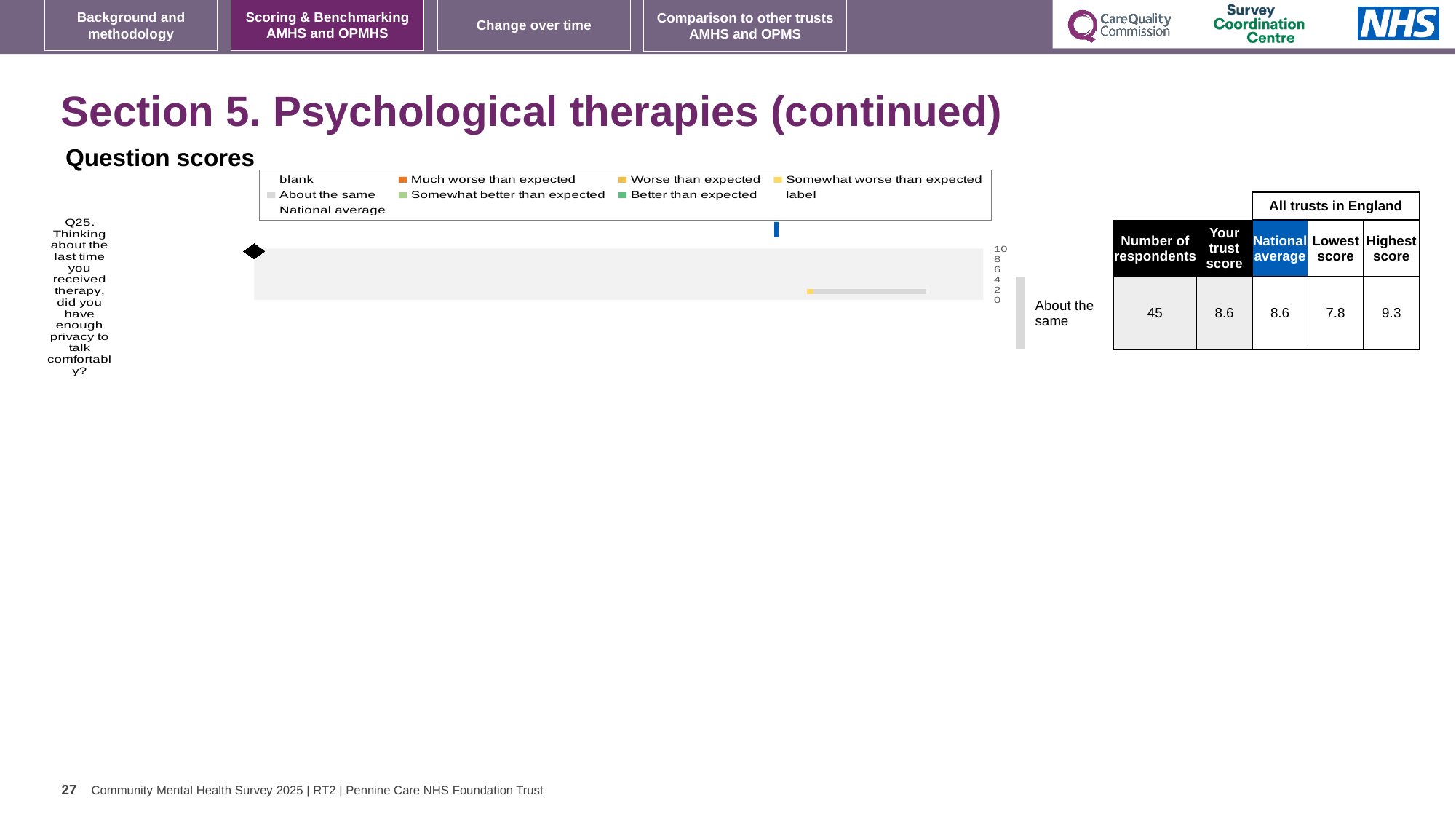
What is the trust score for Q25? 8.6 What is the difference between the trust score and the national average for Q25? 0 What benchmark category is shown for Q25? About the same What is the number of respondents for Q25? 45 What kind of chart is shown under 'Question scores'? bar chart What is the lowest score among all trusts in England for Q25? 7.8 How many survey questions are plotted in the chart? 1 What is the highest score among all trusts in England for Q25? 9.3 Which question number is plotted in the chart? Q25 What is the national average for Q25? 8.6 What colour does the legend use for 'Much worse than expected'? orange What is the difference between the highest score and the lowest score for Q25? 1.5